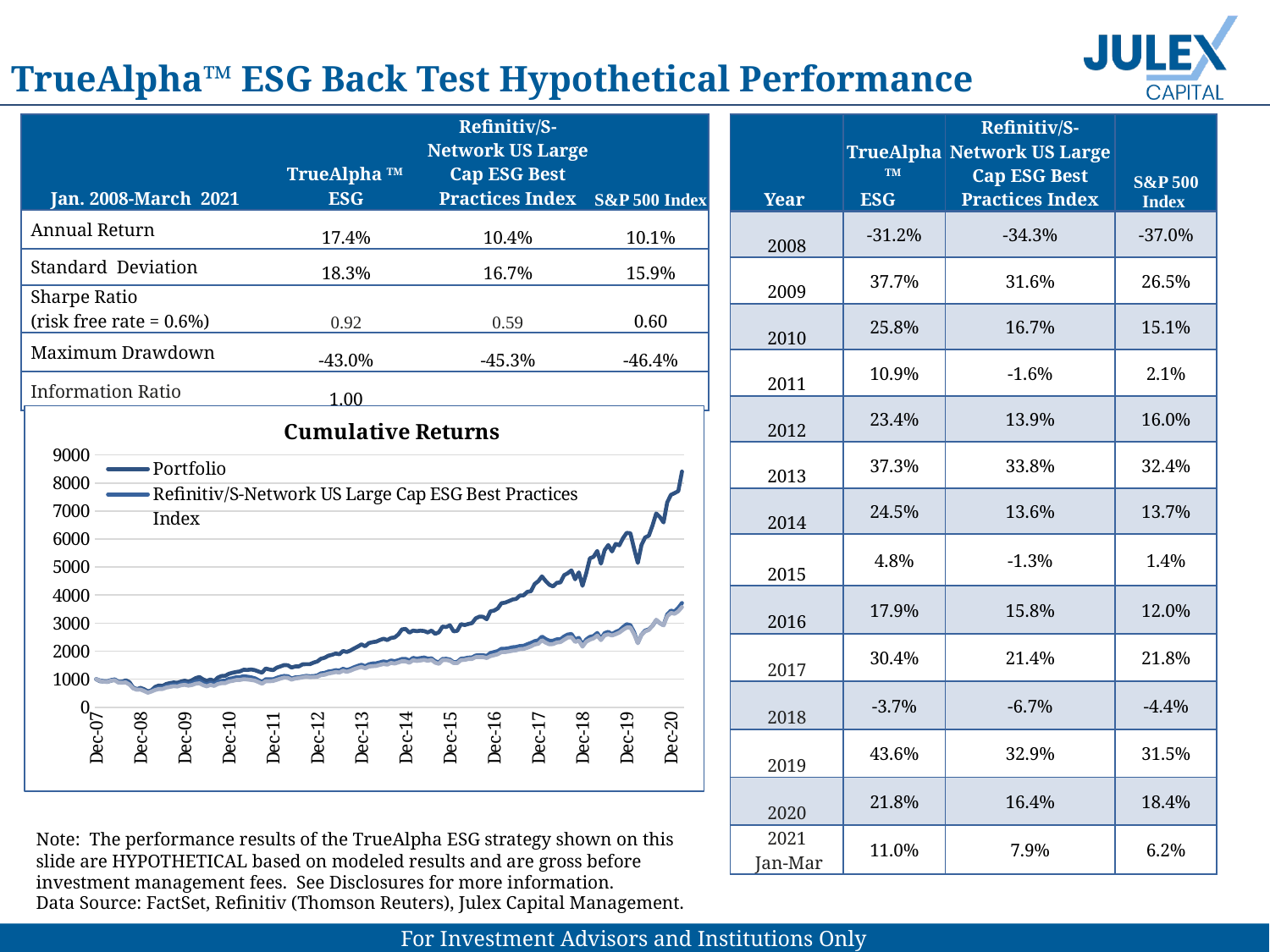
In the "Cumulative Returns" chart, do the values of the Portfolio series generally rise or fall from Dec-07 to Dec-20? rise How many series does the legend of the "Cumulative Returns" chart list? 2 In the "Cumulative Returns" chart, is the Portfolio value at Dec-20 greater or less than 7000? greater In the "Cumulative Returns" chart, is the Refinitiv/S-Network US Large Cap ESG Best Practices Index value at Dec-20 greater or less than 5000? less In the "Cumulative Returns" chart, is the Refinitiv/S-Network US Large Cap ESG Best Practices Index value at Dec-20 greater or less than 3000? greater What are the two series named in the legend of the "Cumulative Returns" chart? Portfolio; Refinitiv/S-Network US Large Cap ESG Best Practices Index What is the title of the chart on the slide? Cumulative Returns In the "Cumulative Returns" chart, which series is higher at Dec-20, Portfolio or the Refinitiv/S-Network US Large Cap ESG Best Practices Index? Portfolio How many date labels are shown on the x axis of the "Cumulative Returns" chart? 14 What kind of chart is the "Cumulative Returns" chart? line chart